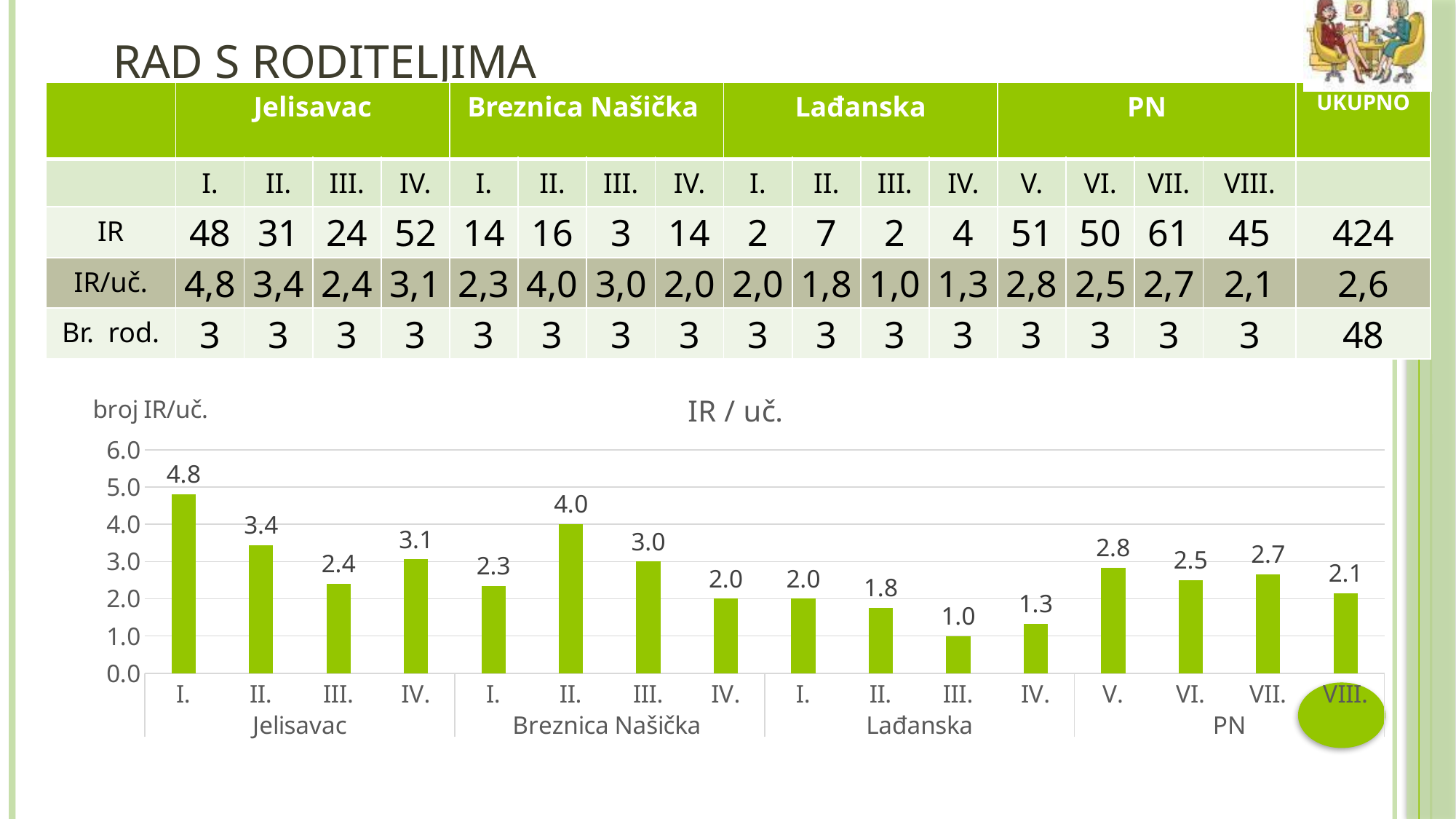
Is the value for class IV. in Lađanska greater or less than 2.0 in the IR / uč. chart? less What is the value for class I. in the Jelisavac group in the IR / uč. chart? 4.8 How many bars are plotted in the IR / uč. chart? 16 What is the value for class II. in the Breznica Našička group in the IR / uč. chart? 4.0 What kind of chart is the IR / uč. chart? bar chart What is the difference between the value for class I. in Jelisavac and class III. in Lađanska in the IR / uč. chart? 3.8 Which bar has the lowest value in the IR / uč. chart? III. (Lađanska) What is the value for class VIII. in the PN group in the IR / uč. chart? 2.1 In the IR / uč. chart, which is larger: the value for class II. in Jelisavac or class III. in Breznica Našička? II. in Jelisavac What is the title of the chart on the slide? IR / uč. Which bar has the highest value in the IR / uč. chart? I. (Jelisavac) What is the label on the vertical axis of the IR / uč. chart? broj IR/uč.